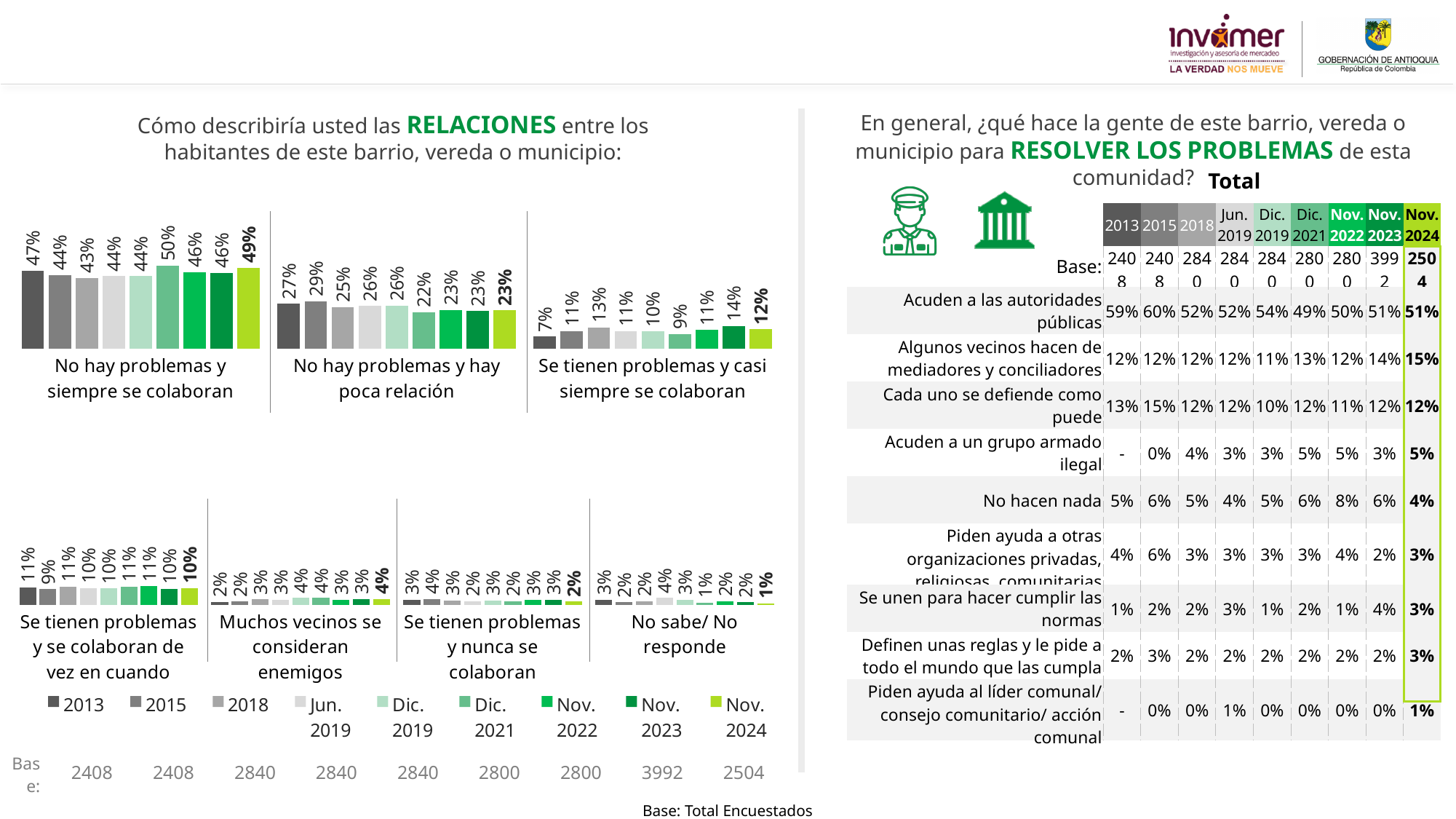
How many series (survey waves) does the legend of the chart on the left list? 9 In the chart on the left, what is the 2013 value for 'No hay problemas y hay poca relación'? 27% How many response categories does the chart on the left show? 7 In the chart on the left, what is the Nov. 2023 value for 'Se tienen problemas y casi siempre se colaboran'? 14% In the chart on the left, what is the base (number of respondents) shown for Nov. 2024? 2504 In the chart on the left, what is the difference between the 2015 and Nov. 2024 values for 'No hay problemas y hay poca relación'? 6 percentage points In the chart on the left, which year has the highest value for 'No hay problemas y siempre se colaboran'? Dic. 2021 In the chart on the left, which year has the lowest value for 'Se tienen problemas y casi siempre se colaboran'? 2013 In the chart on the left about RELACIONES, what is the Nov. 2024 value for 'No hay problemas y siempre se colaboran'? 49% In the chart on the left, for 'No hay problemas y siempre se colaboran', which is larger: the 2018 value or the Nov. 2024 value? Nov. 2024 In the chart on the left, does the value for 'No hay problemas y hay poca relación' rise or fall from 2015 to Nov. 2024? Fall What type of chart is used on the left side of the slide? Bar chart